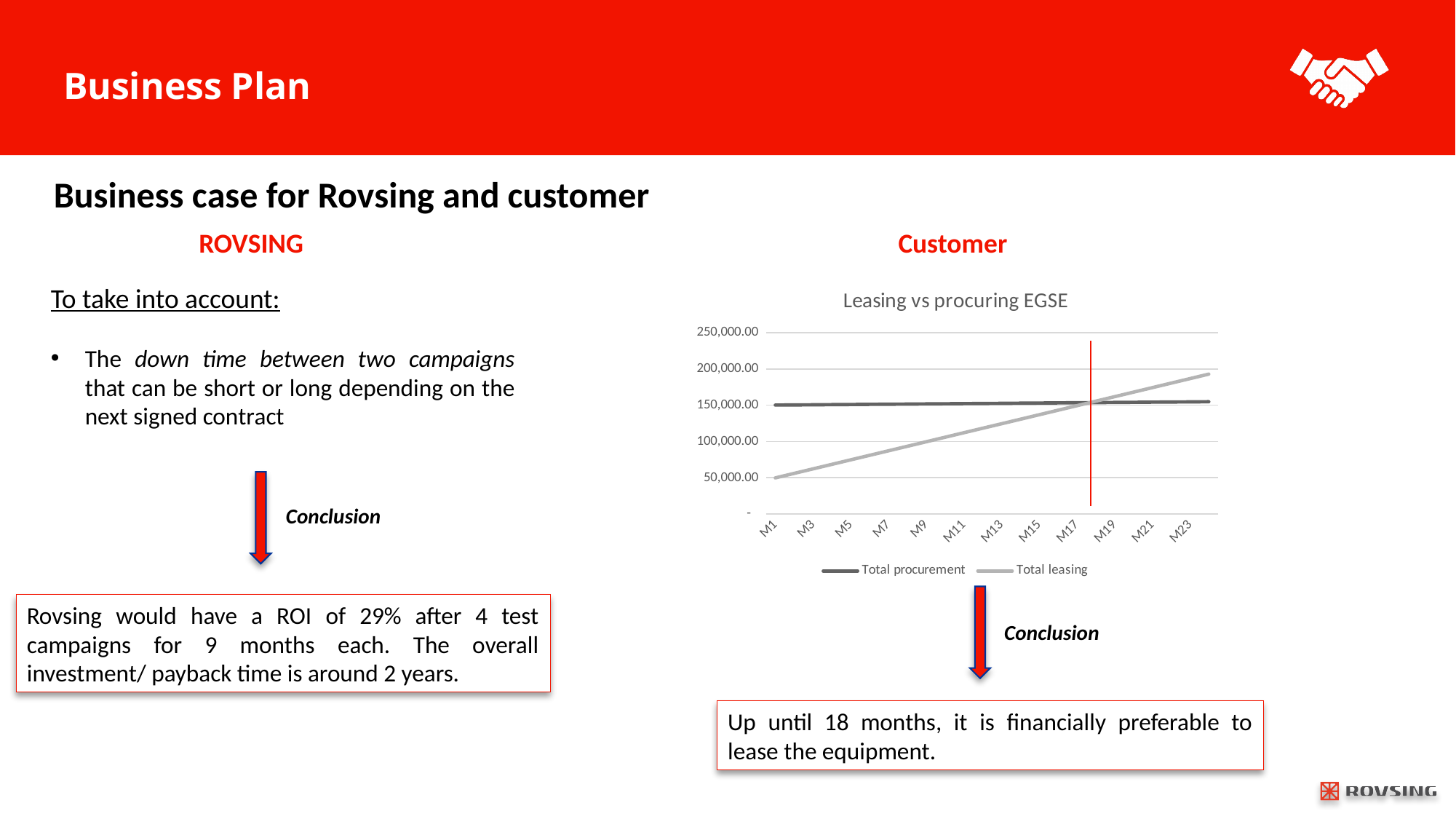
In the Leasing vs procuring EGSE chart, at M23 which series has the larger value, Total procurement or Total leasing? Total leasing In the Leasing vs procuring EGSE chart, at M1 which series has the larger value, Total procurement or Total leasing? Total procurement In the Leasing vs procuring EGSE chart, is the Total leasing value at M5 greater or less than 100,000.00? less In the Leasing vs procuring EGSE chart, is the Total procurement value at M1 greater or less than 100,000.00? greater In the Leasing vs procuring EGSE chart, is the Total leasing value at M1 greater or less than 100,000.00? less How many series does the legend of the Leasing vs procuring EGSE chart list? 2 What is the title of the chart on the slide? Leasing vs procuring EGSE Which two series are listed in the legend of the Leasing vs procuring EGSE chart? Total procurement and Total leasing In the Leasing vs procuring EGSE chart, does the Total leasing line rise or fall from M1 to M23? rise What kind of chart is shown under the Customer heading? line chart